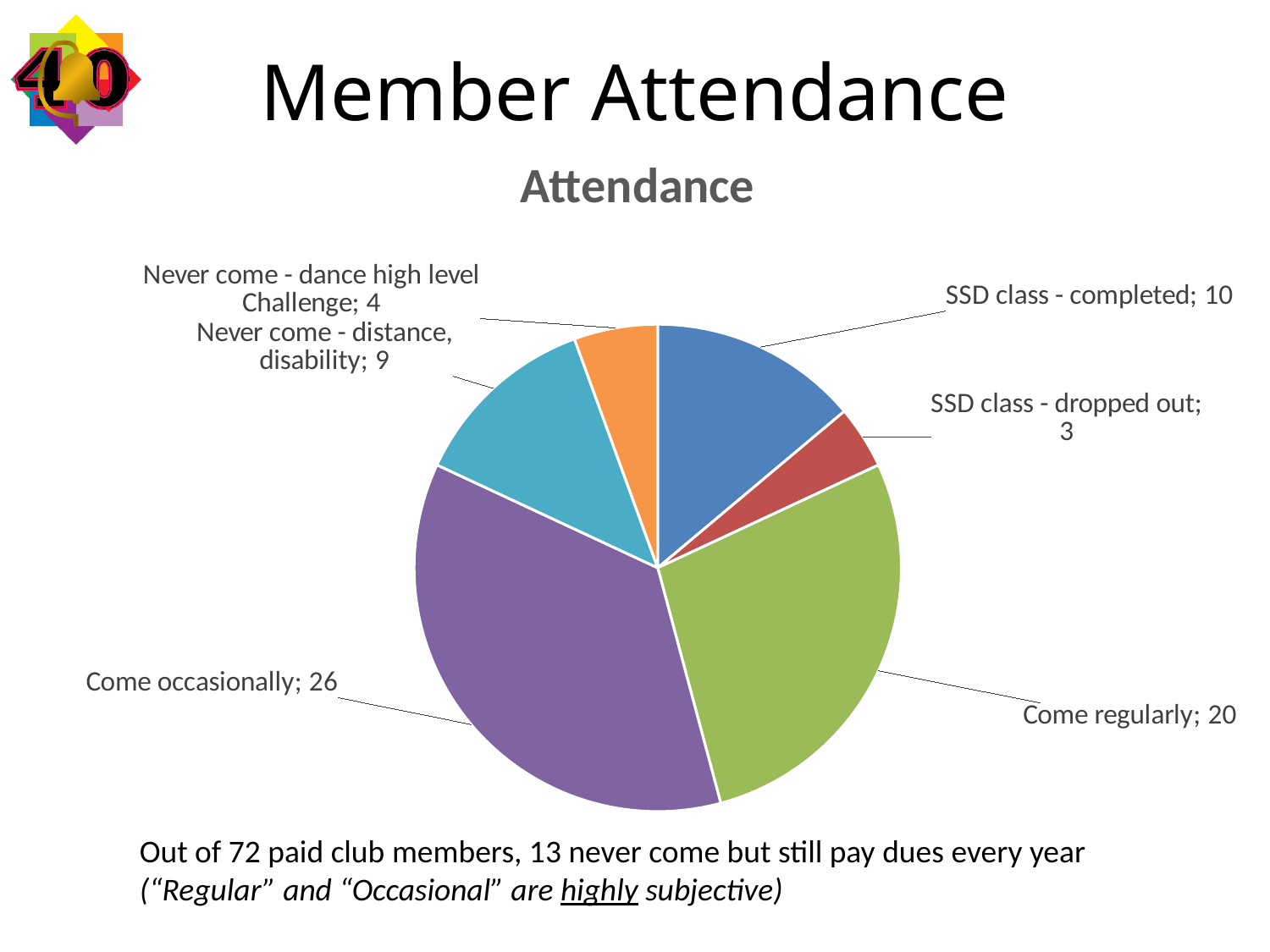
What is the value for 'Never come - distance, disability'? 9 What is the value for 'Come regularly'? 20 What is the difference between 'Come occasionally' and 'Come regularly'? 6 What is the title of the chart? Attendance Which category has the smallest slice? SSD class - dropped out Which category has the largest slice? Come occasionally Which is larger, 'SSD class - completed' or 'Never come - dance high level Challenge'? SSD class - completed What is the value for 'Come occasionally'? 26 What is the total of all slices in the pie chart? 72 What type of chart is shown on the slide? Pie chart How many slices does the pie chart have? 6 What is the value for 'SSD class - completed'? 10